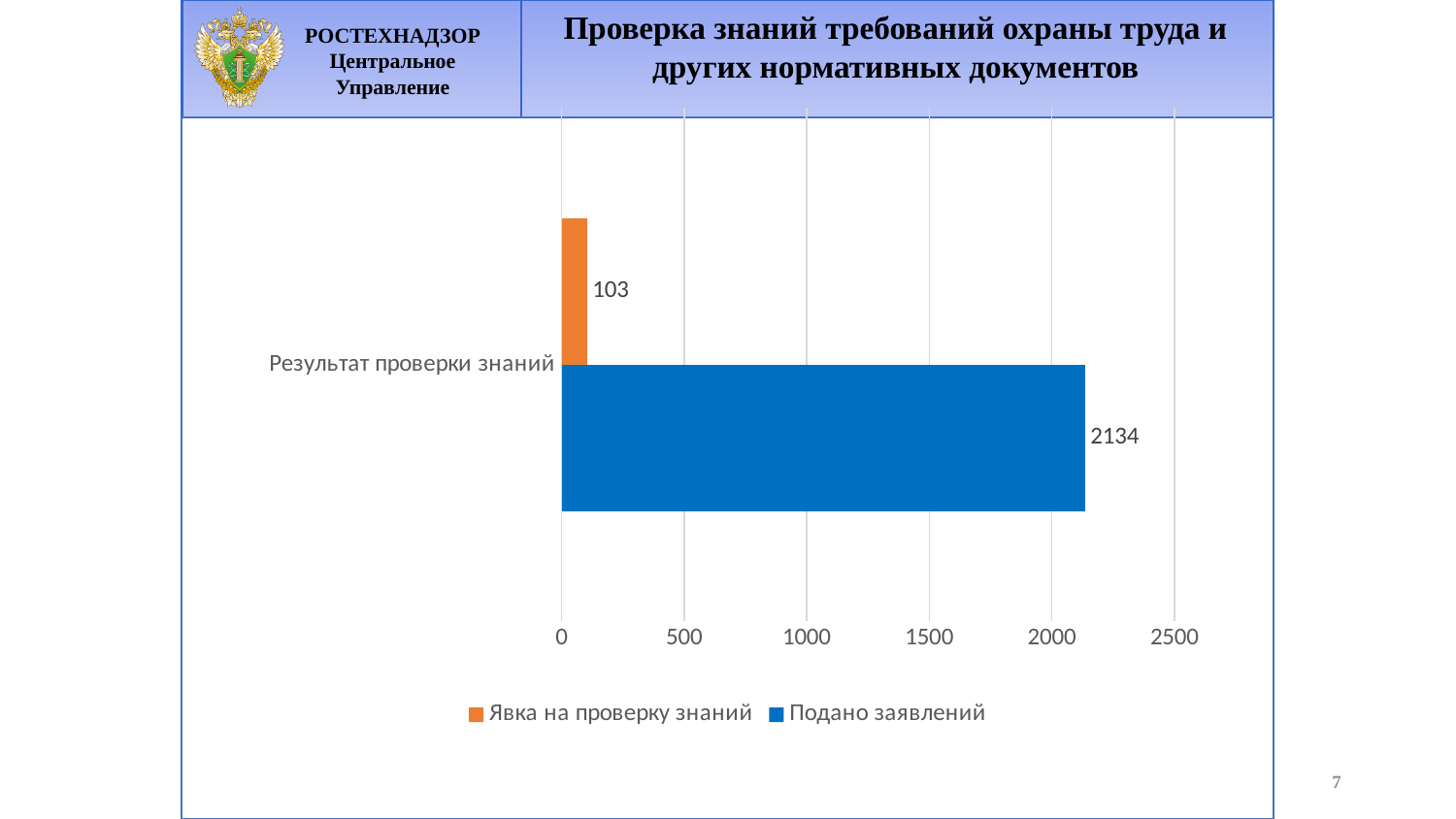
What is the value for "Подано заявлений" in the chart? 2134 Which colour represents "Подано заявлений" in the chart? blue Is the value for "Подано заявлений" greater or less than 2000? greater What is the maximum value shown on the horizontal axis? 2500 Which series has the higher value, "Подано заявлений" or "Явка на проверку знаний"? Подано заявлений What is the difference between "Подано заявлений" and "Явка на проверку знаний"? 2031 What is the category label shown on the vertical axis? Результат проверки знаний How many series does the legend list? 2 What kind of chart is shown on the slide? bar chart What is the value for "Явка на проверку знаний" in the chart? 103 How many categories are shown on the vertical axis of the chart? 1 Is the value for "Явка на проверку знаний" greater or less than 500? less